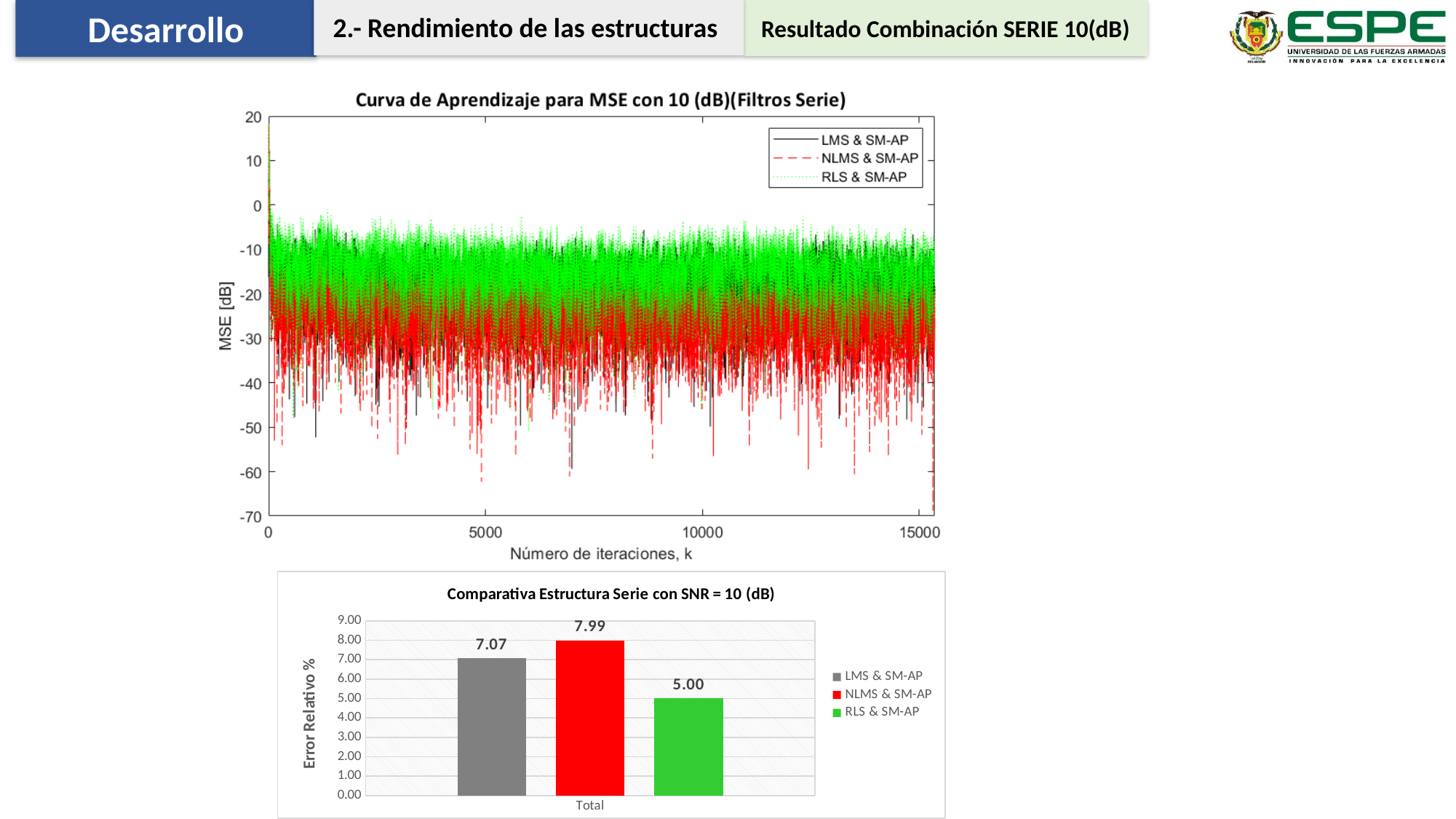
In the bar chart 'Comparativa Estructura Serie con SNR = 10 (dB)', what is the difference between the NLMS & SM-AP and LMS & SM-AP values? 0.92 In the bar chart 'Comparativa Estructura Serie con SNR = 10 (dB)', what is the Error Relativo % for NLMS & SM-AP? 7.99 What kind of chart is the upper chart titled 'Curva de Aprendizaje para MSE con 10 (dB)(Filtros Serie)'? line chart How many series does the legend of the bar chart 'Comparativa Estructura Serie con SNR = 10 (dB)' list? 3 In the bar chart 'Comparativa Estructura Serie con SNR = 10 (dB)', is the value for RLS & SM-AP greater or less than 6.00? less In the bar chart 'Comparativa Estructura Serie con SNR = 10 (dB)', which is larger, the value for LMS & SM-AP or for RLS & SM-AP? LMS & SM-AP In the bar chart 'Comparativa Estructura Serie con SNR = 10 (dB)', which series has the highest Error Relativo %? NLMS & SM-AP In the bar chart 'Comparativa Estructura Serie con SNR = 10 (dB)', what is the Error Relativo % for RLS & SM-AP? 5.00 What kind of chart is the lower chart titled 'Comparativa Estructura Serie con SNR = 10 (dB)'? bar chart In the bar chart 'Comparativa Estructura Serie con SNR = 10 (dB)', what is the Error Relativo % for LMS & SM-AP? 7.07 In the bar chart 'Comparativa Estructura Serie con SNR = 10 (dB)', what is the difference between the LMS & SM-AP and RLS & SM-AP values? 2.07 In the bar chart 'Comparativa Estructura Serie con SNR = 10 (dB)', which series has the lowest Error Relativo %? RLS & SM-AP